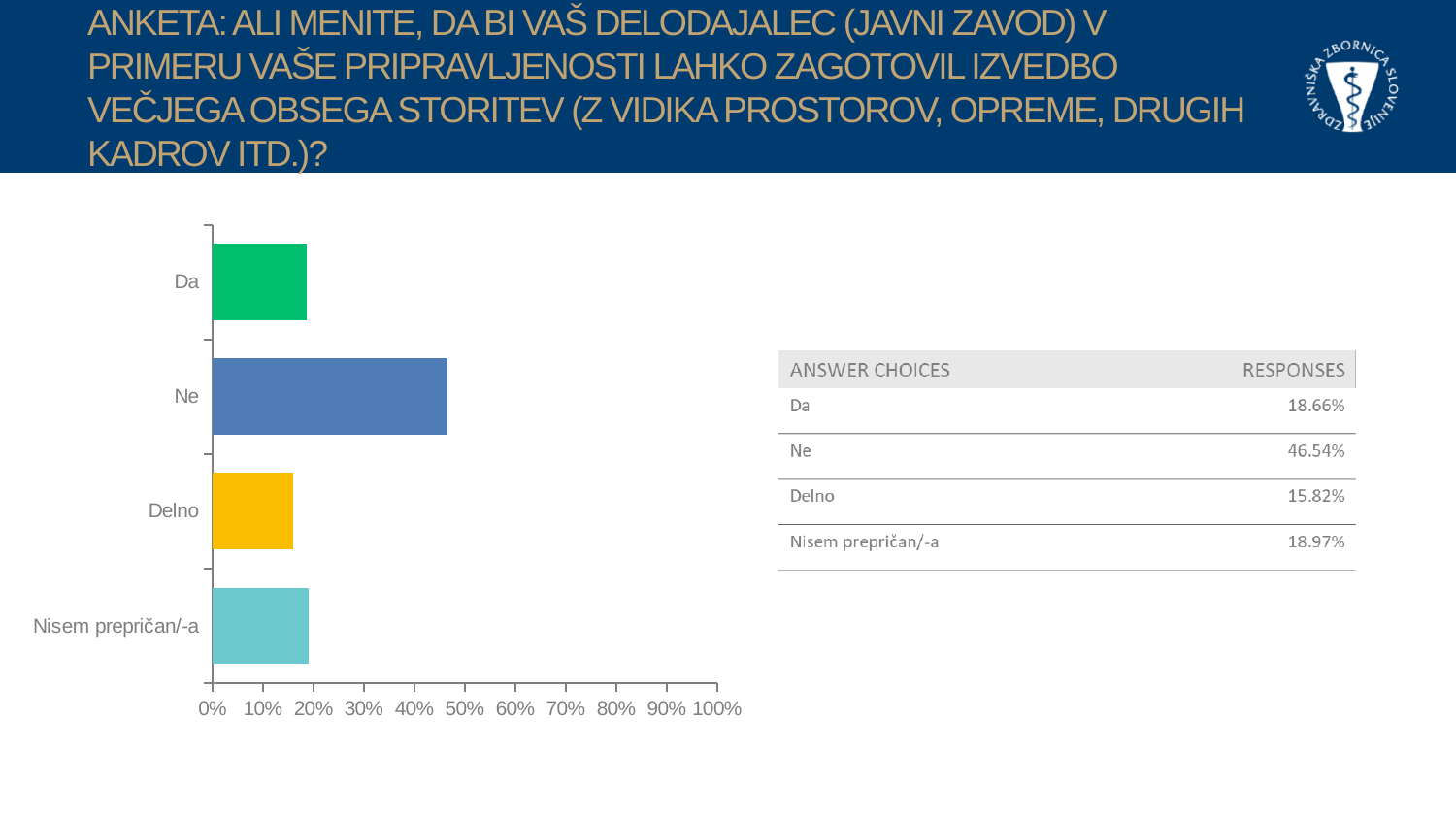
Which answer choice received the lowest share of responses? Delno Is the value for "Ne" greater or less than 40%? greater What kind of chart is shown on the slide? bar chart What percentage of responses were "Delno"? 15.82% Which received a larger share of responses, "Ne" or "Delno"? Ne How many answer choices are shown in the chart? 4 What is the difference in percentage points between the "Ne" and "Delno" responses? 30.72 What percentage of responses were "Da"? 18.66% What percentage of responses were "Ne"? 46.54% Which answer choice received the highest share of responses? Ne What is the difference in percentage points between the "Ne" and "Da" responses? 27.88 What percentage of responses were "Nisem prepričan/-a"? 18.97%